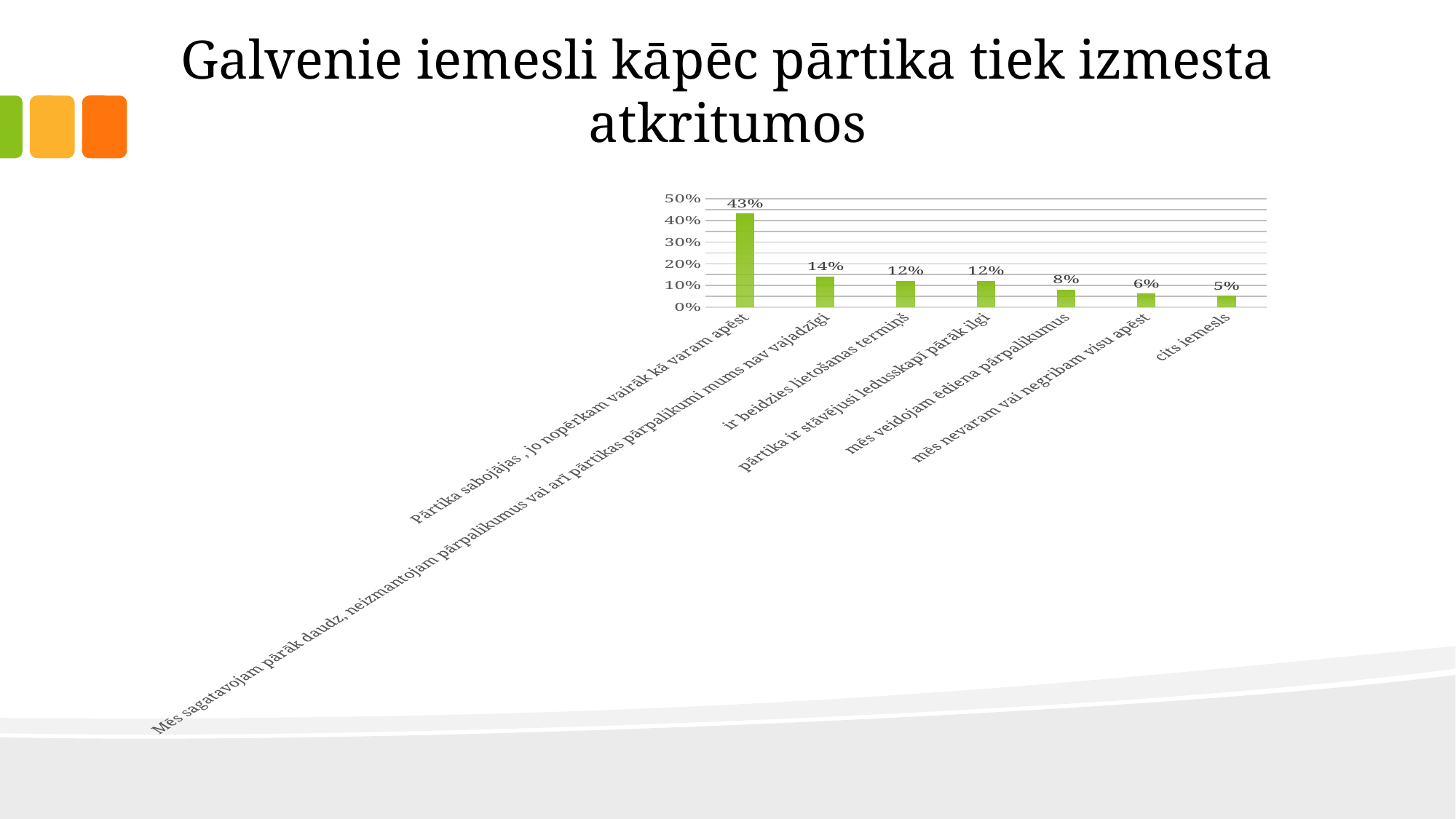
Which is larger: the value for "mēs veidojam ēdiena pārpalikumus" or the value for "mēs nevaram vai negribam visu apēst"? mēs veidojam ēdiena pārpalikumus What kind of chart is shown on the slide? bar chart How many categories are shown in the chart? 7 What is the difference between the value for "Pārtika sabojājas, jo nopērkam vairāk kā varam apēst" and the value for "cits iemesls"? 38% Do the values rise or fall from left to right along the x axis? fall What is the value for "cits iemesls"? 5% What is the value for "ir beidzies lietošanas termiņš"? 12% What is the value for "mēs veidojam ēdiena pārpalikumus"? 8% What is the value for "mēs nevaram vai negribam visu apēst"? 6% Which category has the highest value? Pārtika sabojājas, jo nopērkam vairāk kā varam apēst Is the value for "Pārtika sabojājas, jo nopērkam vairāk kā varam apēst" greater or less than 40%? greater Which category has the lowest value? cits iemesls